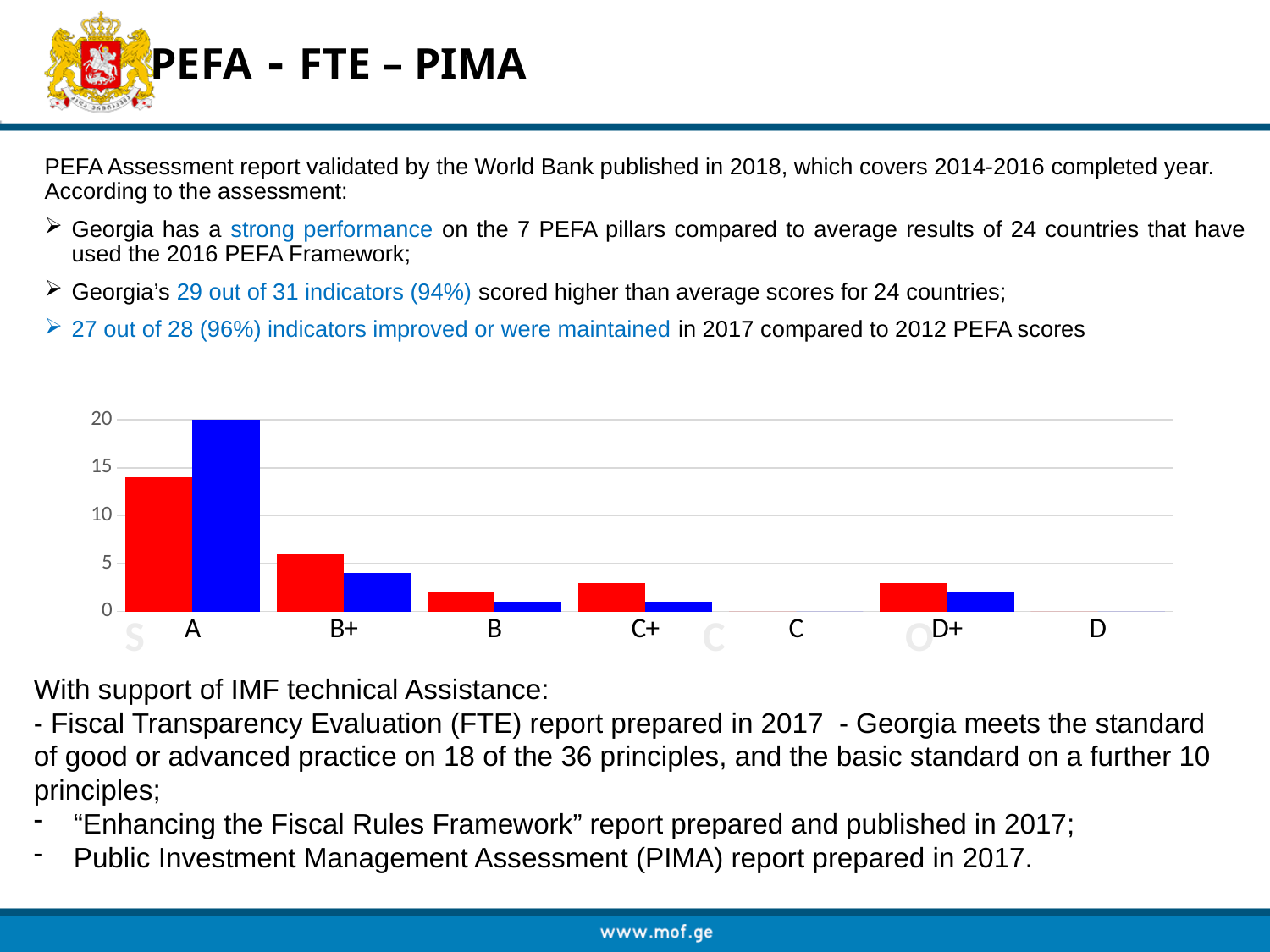
For category B+, which bar is taller, the red one or the blue one? red Is the value of the blue bar for category D+ greater or less than 5? less Is the value of the red bar for category B less than or greater than 5? less What is the value of the blue bar for category A? 20 How many categories are shown on the x axis of the chart? 7 What kind of chart is shown on the slide? bar chart Which category has the tallest bar in the chart? A Which two categories show no visible bars in the chart? C and D What two colours are used for the bars in the chart? red and blue For category A, which bar is taller, the red one or the blue one? blue Is the value of the red bar for category A greater or less than 10? greater